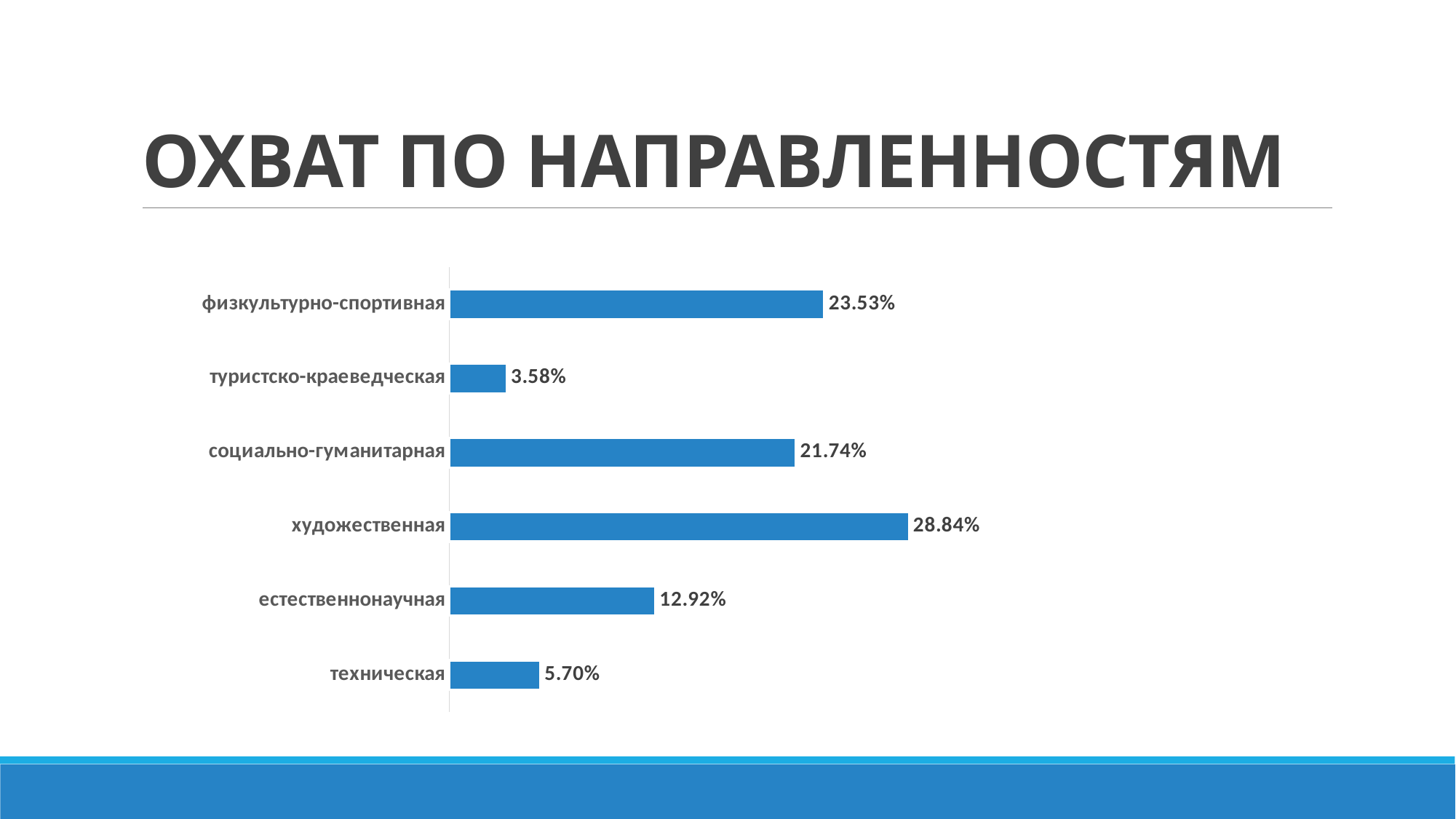
What is the value for естественнонаучная? 12.92% What is the title of the slide? ОХВАТ ПО НАПРАВЛЕННОСТЯМ Which category has the highest value? художественная Which is larger, естественнонаучная or техническая? естественнонаучная What is the value for художественная? 28.84% How many categories are shown in the chart? 6 What is the difference between художественная and техническая? 23.14% What is the value for туристско-краеведческая? 3.58% What is the value for техническая? 5.70% Which category has the lowest value? туристско-краеведческая What kind of chart is shown on the slide? bar chart What is the difference between физкультурно-спортивная and социально-гуманитарная? 1.79%